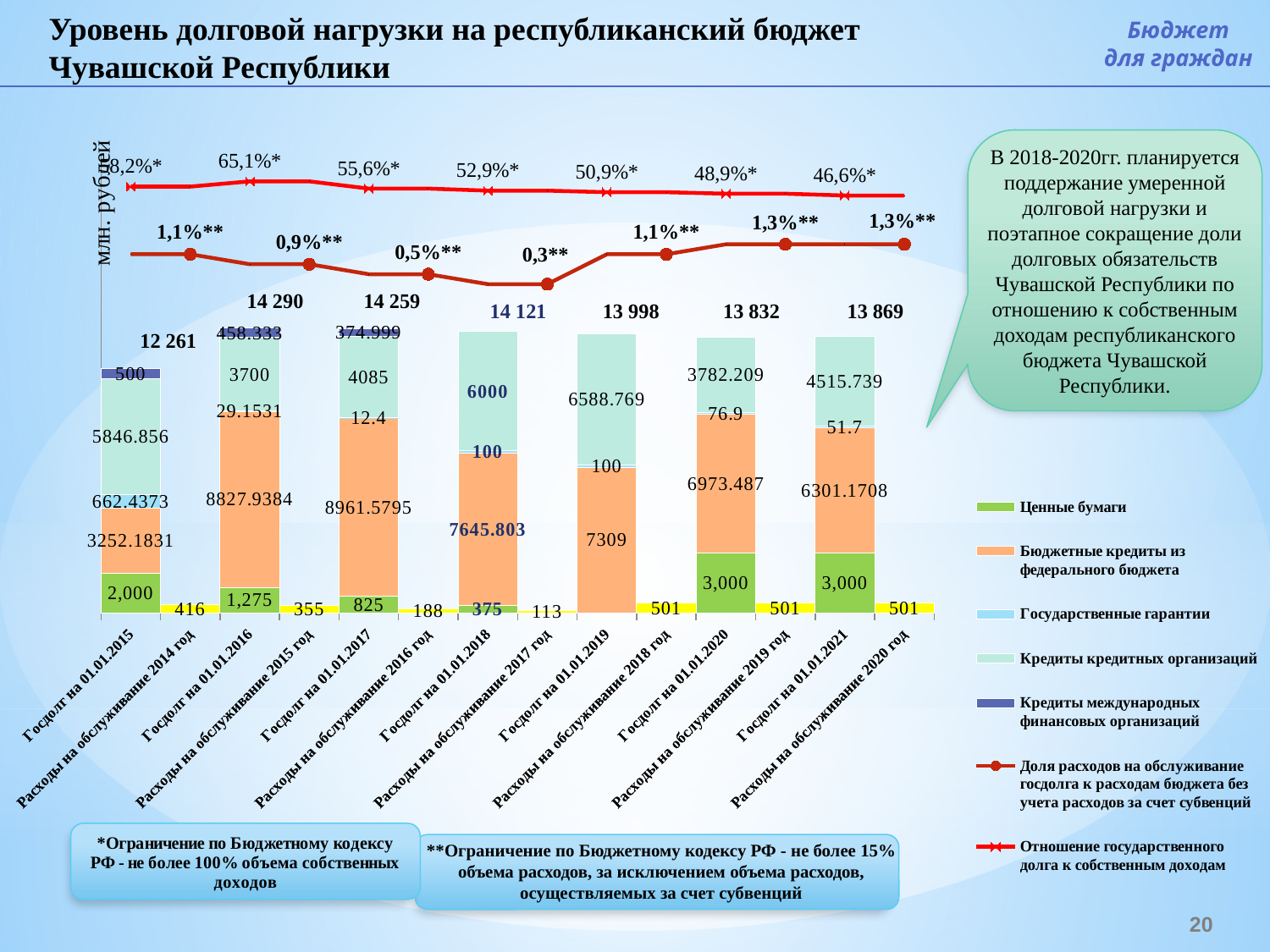
Which Госдолг bar has the highest total value? Госдолг на 01.01.2016 What is the value of Отношение государственного долга к собственным доходам at Госдолг на 01.01.2021? 46,6% Which is larger: Расходы на обслуживание 2014 год or Расходы на обслуживание 2015 год? Расходы на обслуживание 2014 год What is the value of Бюджетные кредиты из федерального бюджета for Госдолг на 01.01.2019? 7309 How many series does the legend list? 7 What is the value of Доля расходов на обслуживание госдолга at Госдолг на 01.01.2018? 0,3% Which Госдолг bar has the lowest total value? Госдолг на 01.01.2015 What is the value of Расходы на обслуживание 2017 год? 113 What is the total value of the bar for Госдолг на 01.01.2016? 14 290 What is the difference between the totals for Госдолг на 01.01.2016 and Госдолг на 01.01.2015? 2 029 Does the line Отношение государственного долга к собственным доходам rise or fall from left to right? Falls What kind of chart is shown on the slide? Stacked bar chart with line series